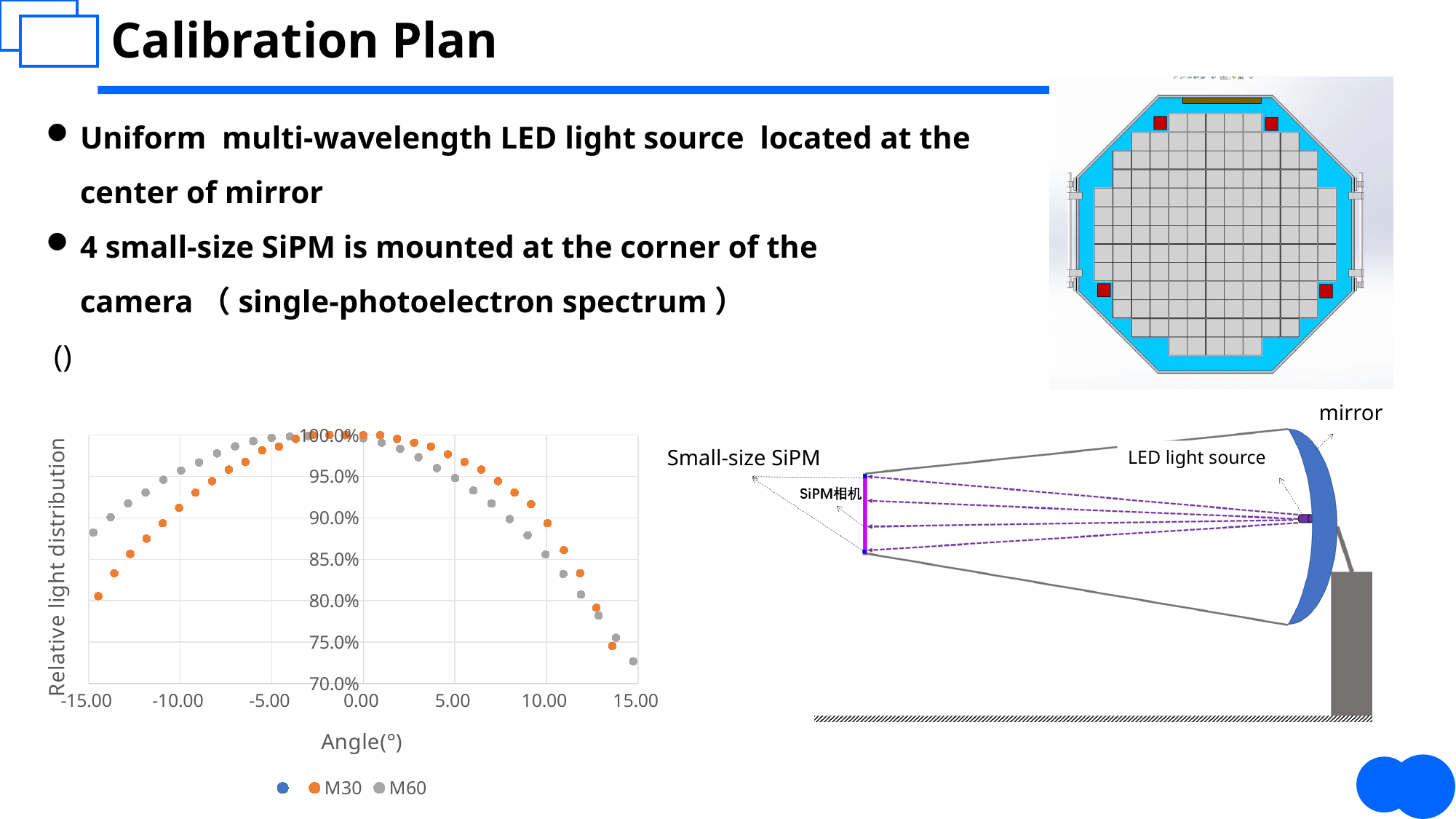
Do the M30 values rise or fall as the angle goes from -15.00 to 0.00? rise What is the title of the vertical axis of the chart? Relative light distribution Is the M60 value at an angle of -15.00 greater or less than 85.0%? greater What kind of chart is shown on the slide? scatter chart Do the M60 values rise or fall as the angle goes from 0.00 to 15.00? fall At an angle of -15.00, which series has the higher value, M30 or M60? M60 Is the M30 value at an angle of -10.00 greater or less than 90.0%? greater What is the title of the horizontal axis of the chart? Angle(°) Is the M60 value at an angle of 15.00 greater or less than 75.0%? less At an angle of 10.00, which series has the higher value, M30 or M60? M30